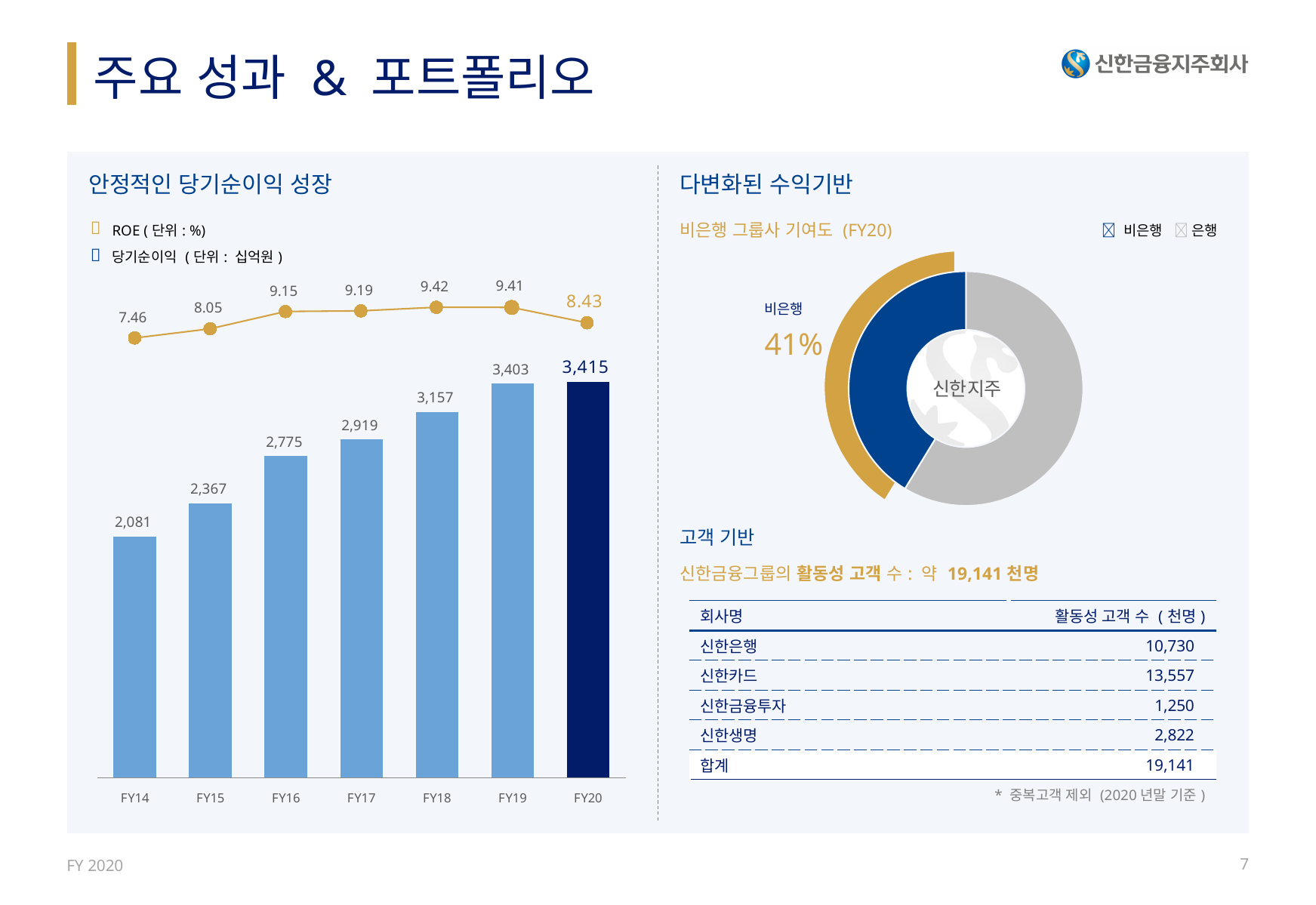
In the left chart (안정적인 당기순이익 성장), which is larger, the ROE for FY16 or the ROE for FY20? FY16 What kind of chart is the right chart (비은행 그룹사 기여도 (FY20))? donut chart In the left chart (안정적인 당기순이익 성장), how many series does the legend list? 2 In the left chart (안정적인 당기순이익 성장), what is the ROE value for FY18? 9.42 In the left chart (안정적인 당기순이익 성장), which fiscal year has the highest 당기순이익? FY20 In the left chart (안정적인 당기순이익 성장), what is the difference in 당기순이익 between FY19 and FY18? 246 In the left chart (안정적인 당기순이익 성장), which fiscal year has the lowest ROE? FY14 In the left chart (안정적인 당기순이익 성장), what unit is given for 당기순이익 in the legend? 십억원 In the right chart (비은행 그룹사 기여도 (FY20)), what share of the donut is 비은행? 41% In the left chart (안정적인 당기순이익 성장), how many fiscal years are shown on the x axis? 7 In the left chart (안정적인 당기순이익 성장), do the 당기순이익 bars rise or fall from FY14 to FY20? rise In the left chart (안정적인 당기순이익 성장), what is the 당기순이익 value for FY17? 2,919